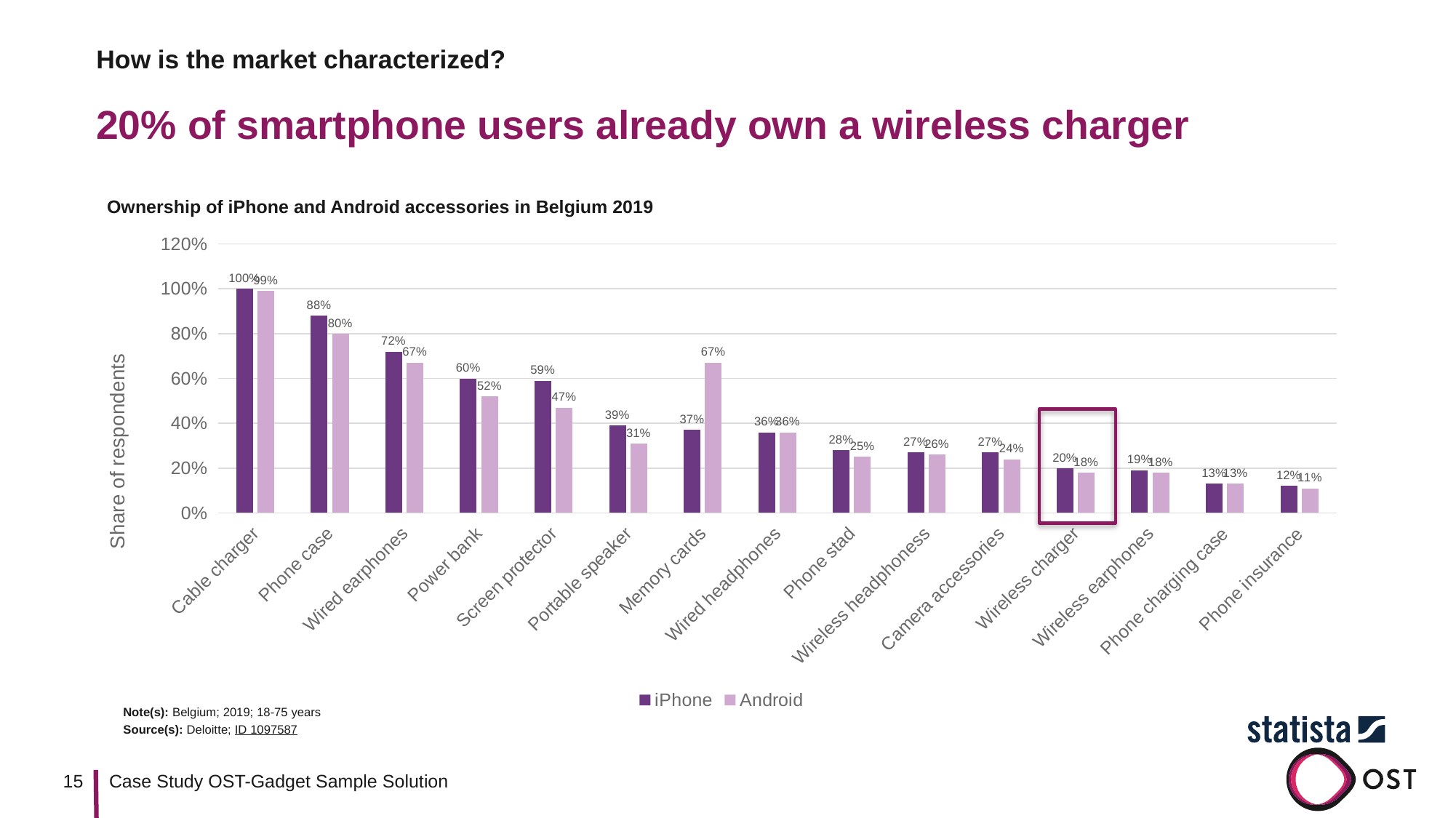
What is the difference between the iPhone and Android values for Power bank? 8% What is the Android value for Phone case? 80% How many accessory categories are shown on the x axis? 15 What is the Android value for Memory cards? 67% For Memory cards, which is larger: the iPhone value or the Android value? Android What kind of chart is shown on the slide? Bar chart What is the iPhone value for Wireless charger? 20% What is the iPhone value for Screen protector? 59% How many series does the legend list? 2 Which category has the highest iPhone value? Cable charger What is the label of the y axis? Share of respondents Which category has the lowest Android value? Phone insurance